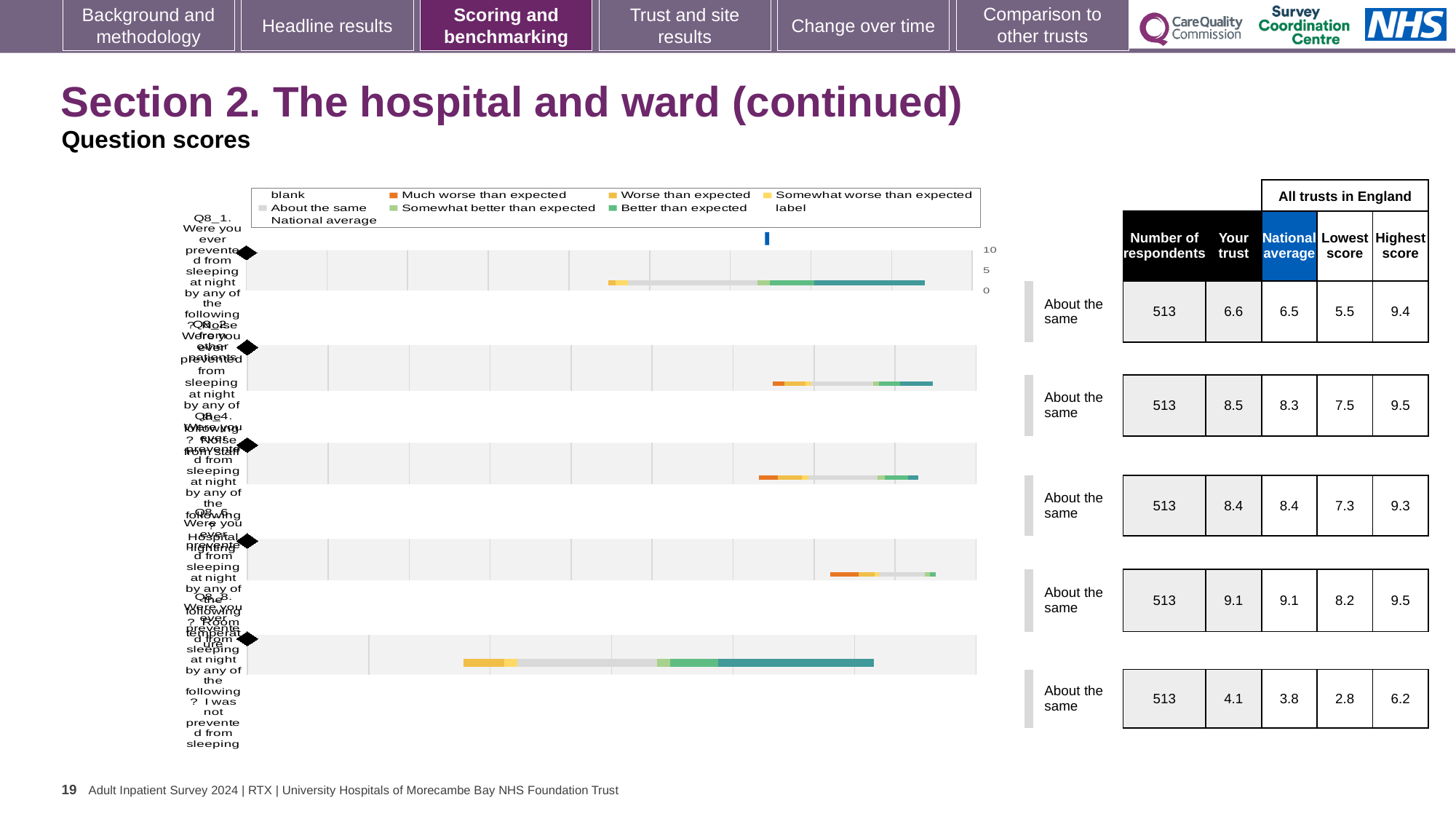
What kind of chart is used to show the question scores on this slide? bar chart Which row has the highest 'Your trust' score? Q8_6 (fourth row), 9.1 Which row has the lowest 'Your trust' score? Q8_8 (bottom row), 4.1 What is the subtitle printed under the slide title 'Section 2. The hospital and ward (continued)'? Question scores For the top row (Q8_1), what is the difference between the highest score and the lowest score across all trusts in England? 3.9 In the table beside the charts, what is the national average for the bottom row (Q8_8)? 3.8 What benchmark category label is shown next to each of the five bar charts? About the same For the bottom row (Q8_8), is the 'Your trust' score or the national average larger? Your trust What is the highest score among all trusts in England for the fourth row (Q8_6)? 9.5 What is the number of respondents shown for the second row (Q8_2)? 513 In the table beside the charts, what is the 'Your trust' score for the top row (Q8_1)? 6.6 How many question rows (bar charts) are shown on the slide? 5